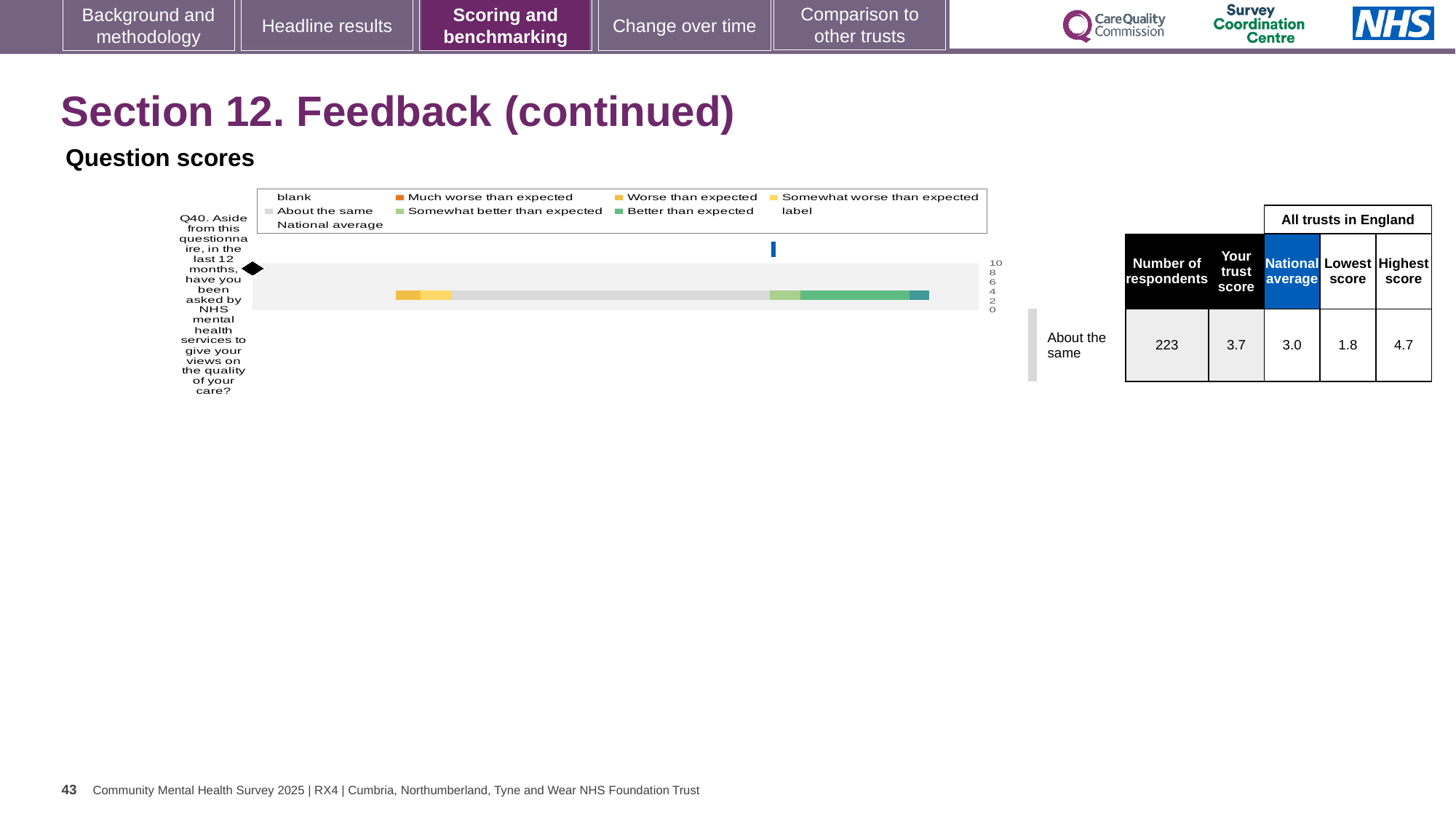
Which benchmark category is shown next to the chart for Q40? About the same How many question categories are plotted in the chart? 1 In the table beside the chart, what is the national average for Q40? 3.0 How many entries does the chart's legend list? 9 In the table beside the chart, what is the lowest score among all trusts in England for Q40? 1.8 In the table beside the chart, what is the number of respondents for Q40? 223 In the table beside the chart, what is the highest score among all trusts in England for Q40? 4.7 What is the difference between the highest score and the lowest score for Q40? 2.9 Which question number is plotted in the chart? Q40 What kind of chart is shown on the slide? bar chart In the table beside the chart, what is the trust score for Q40? 3.7 Which is larger for Q40, the trust score or the national average? trust score